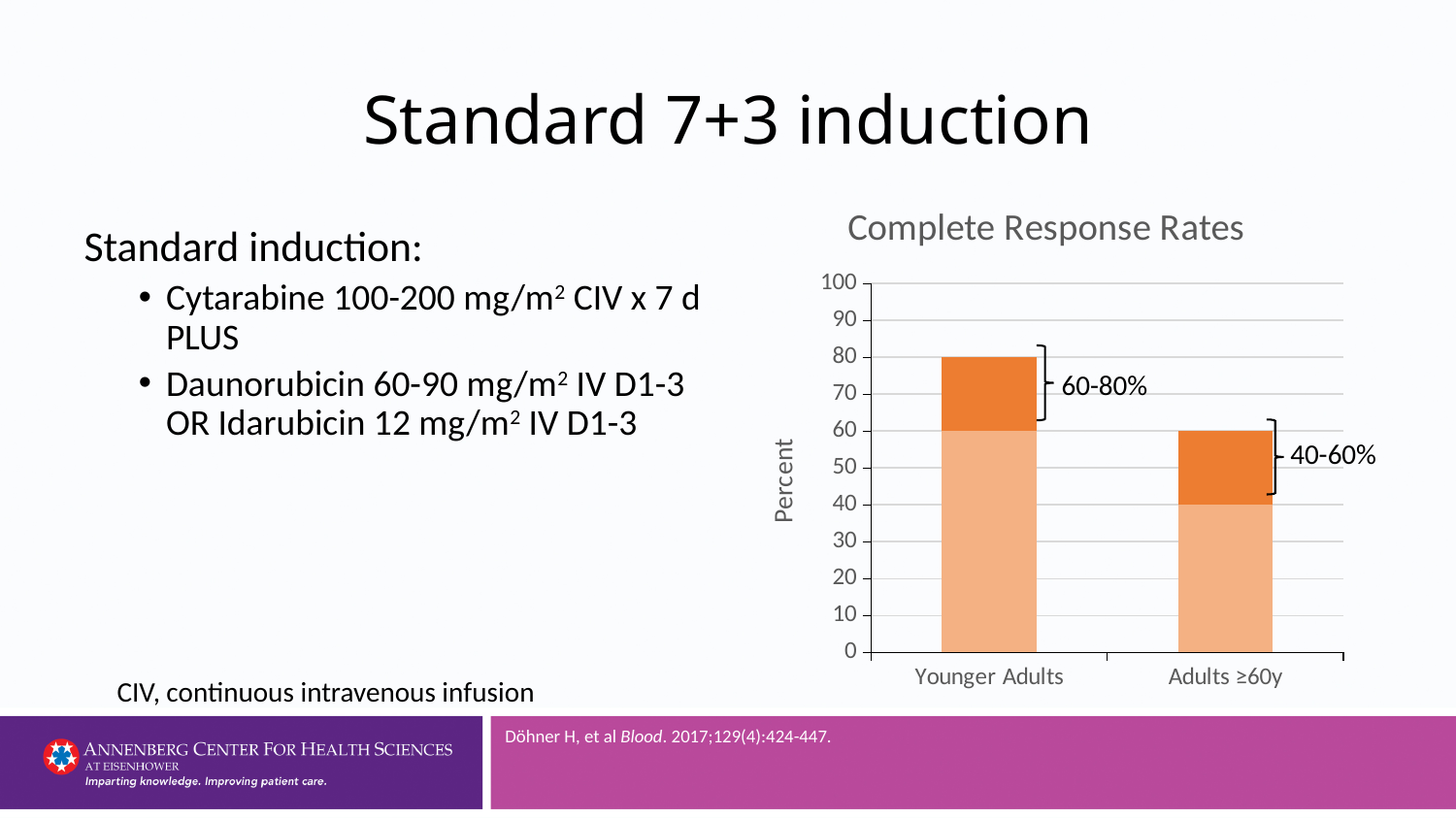
Is the top of the bar for Younger Adults greater or less than 70? greater Which category has the higher complete response rate range? Younger Adults What is the label on the y axis of the chart? Percent What is the title of the chart? Complete Response Rates What kind of chart is shown on the slide? bar chart Which category has the lower complete response rate range? Adults ≥60y Which is larger, the upper bound for Younger Adults or the upper bound for Adults ≥60y? Younger Adults Is the top of the bar for Adults ≥60y greater or less than 70? less How many categories are shown on the x axis of the chart? 2 What complete response rate range is labelled for Adults ≥60y? 40-60% Do the complete response rates rise or fall from Younger Adults to Adults ≥60y? fall What complete response rate range is labelled for Younger Adults? 60-80%